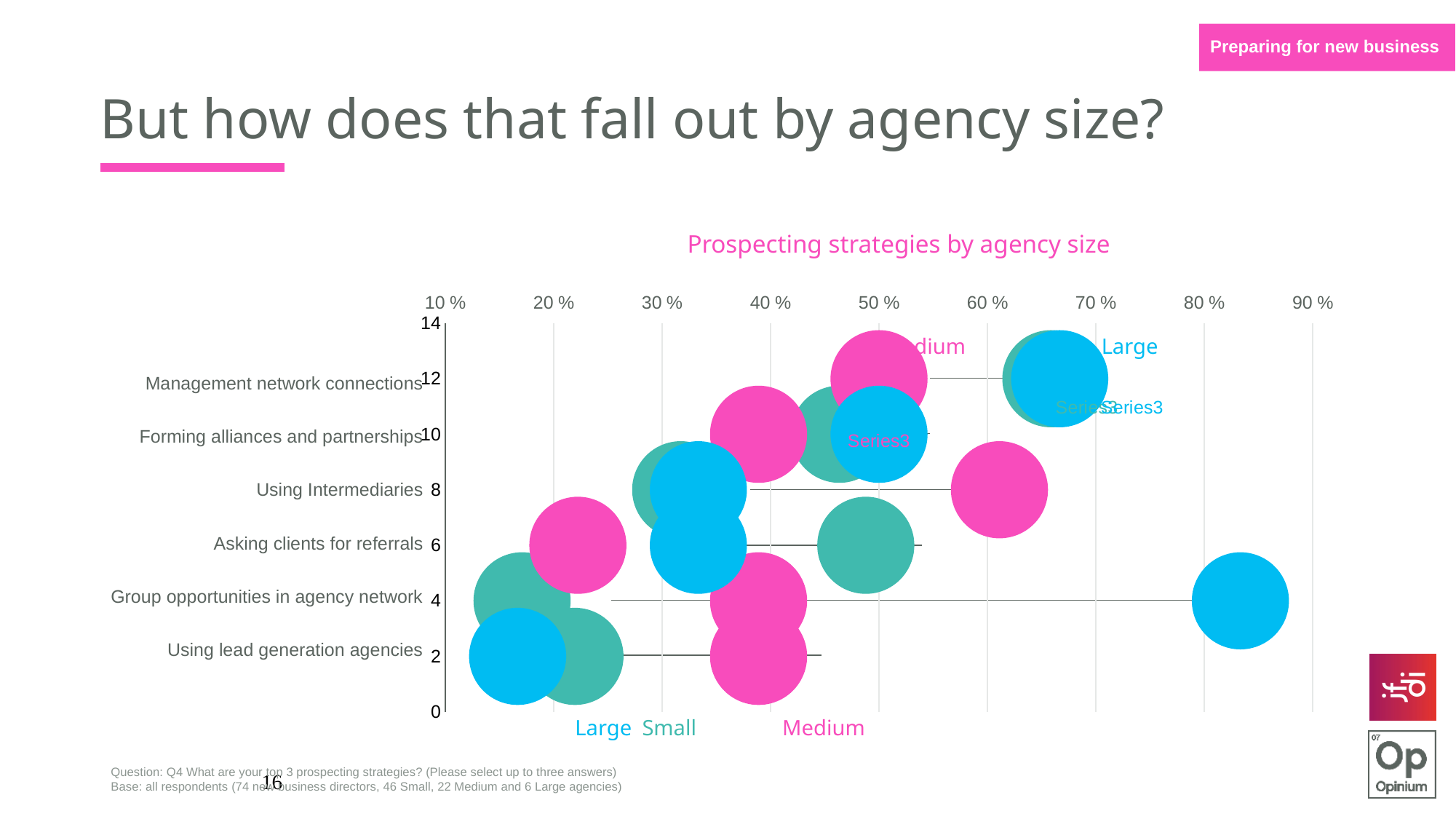
How many prospecting strategies are listed on the vertical axis of the chart? 6 Is the value for Large agencies on 'Management network connections' greater or less than 60 %? greater For 'Using Intermediaries', which agency size has the higher value: Medium or Large? Medium What is the title of the chart? Prospecting strategies by agency size Is the value for Large agencies on 'Group opportunities in agency network' greater or less than 80 %? greater Is the value for Small agencies on 'Forming alliances and partnerships' greater or less than 40 %? greater For which prospecting strategy do Large agencies have their highest value? Group opportunities in agency network Which colour represents Medium agencies in the chart? Pink What type of chart is shown on the slide? Bubble chart For 'Group opportunities in agency network', which agency size has the higher value: Large or Medium? Large How many agency sizes (series) are shown in the chart? 3